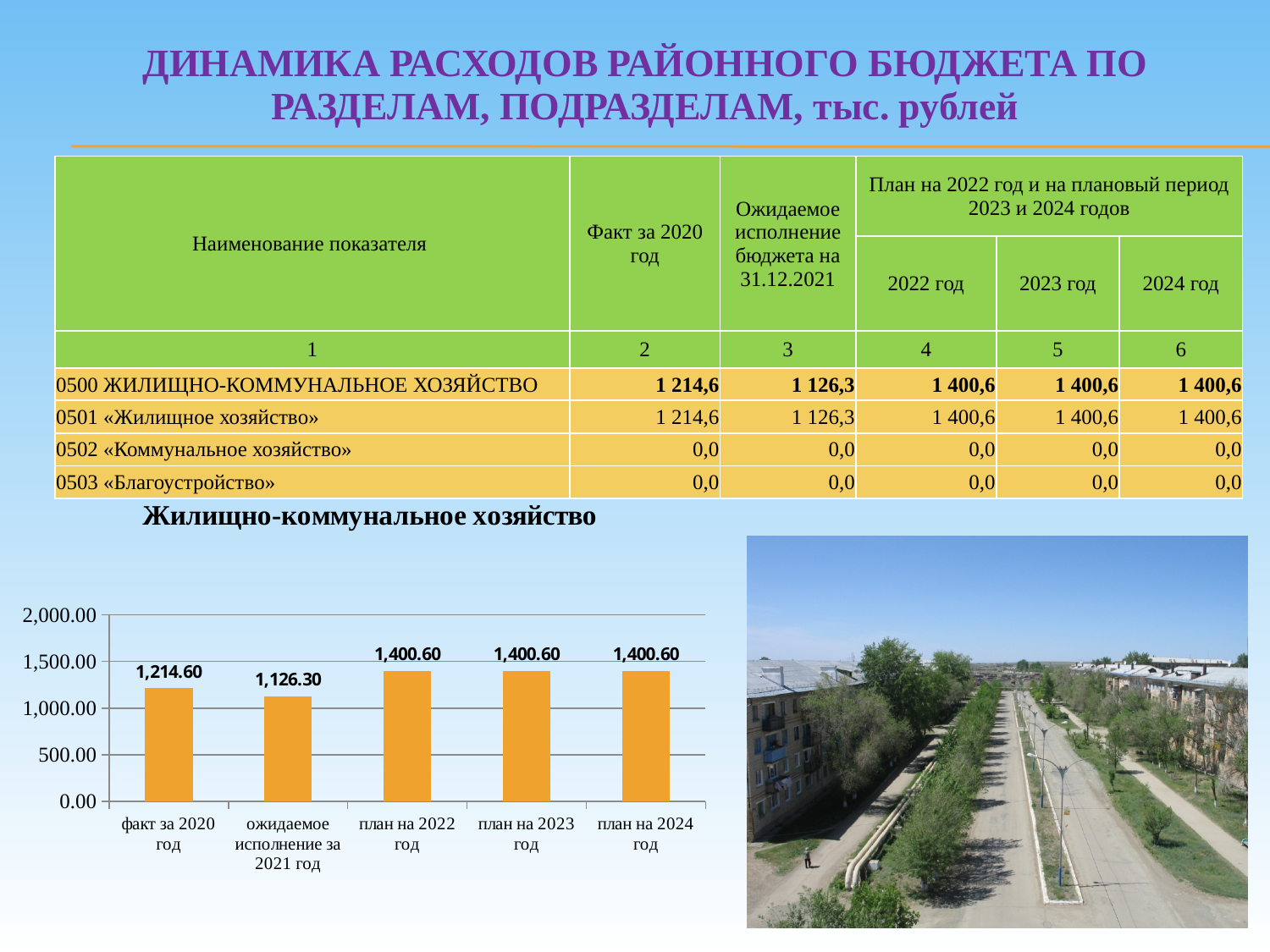
What is the value for "план на 2024 год" in the chart? 1,400.60 Is the value for "план на 2023 год" greater or less than 1,500.00? less What kind of chart is shown on the slide? bar chart What is the value for "план на 2022 год" in the chart? 1,400.60 What is the difference between the values for "факт за 2020 год" and "ожидаемое исполнение за 2021 год"? 88.30 How many categories are shown on the x axis of the chart? 5 Which is larger: the value for "факт за 2020 год" or for "ожидаемое исполнение за 2021 год"? факт за 2020 год What is the title of the chart on the slide? Жилищно-коммунальное хозяйство What is the difference between the values for "план на 2022 год" and "факт за 2020 год"? 186.00 What is the value for "ожидаемое исполнение за 2021 год" in the chart? 1,126.30 What is the value for "факт за 2020 год" in the chart "Жилищно-коммунальное хозяйство"? 1,214.60 Which category has the lowest value in the chart? ожидаемое исполнение за 2021 год